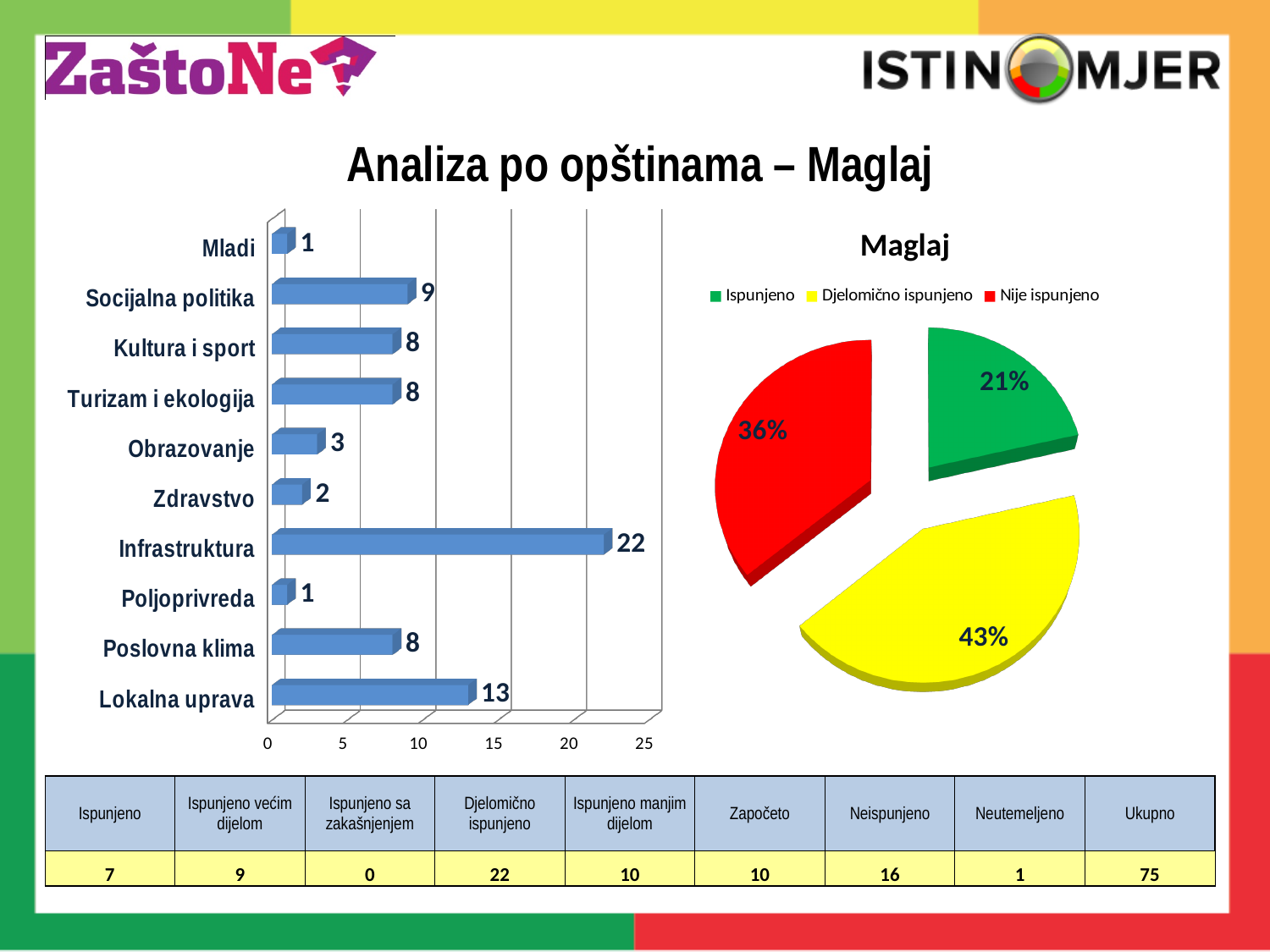
In the bar chart on the left, is the value for Infrastruktura greater or less than 20? greater How many entries does the legend of the pie chart titled Maglaj list? 3 In the pie chart titled Maglaj, which slice is the smallest? Ispunjeno In the bar chart on the left, what is the value for Lokalna uprava? 13 In the bar chart on the left, which category has the highest value? Infrastruktura In the bar chart on the left, what is the difference between the values for Infrastruktura and Lokalna uprava? 9 In the bar chart on the left, what is the value for Infrastruktura? 22 In the bar chart on the left, which is larger, the value for Obrazovanje or the value for Zdravstvo? Obrazovanje In the pie chart titled Maglaj, what share does Djelomično ispunjeno have? 43% In the bar chart on the left, what is the value for Socijalna politika? 9 How many categories does the bar chart on the left show? 10 What kind of chart is the chart on the left? bar chart